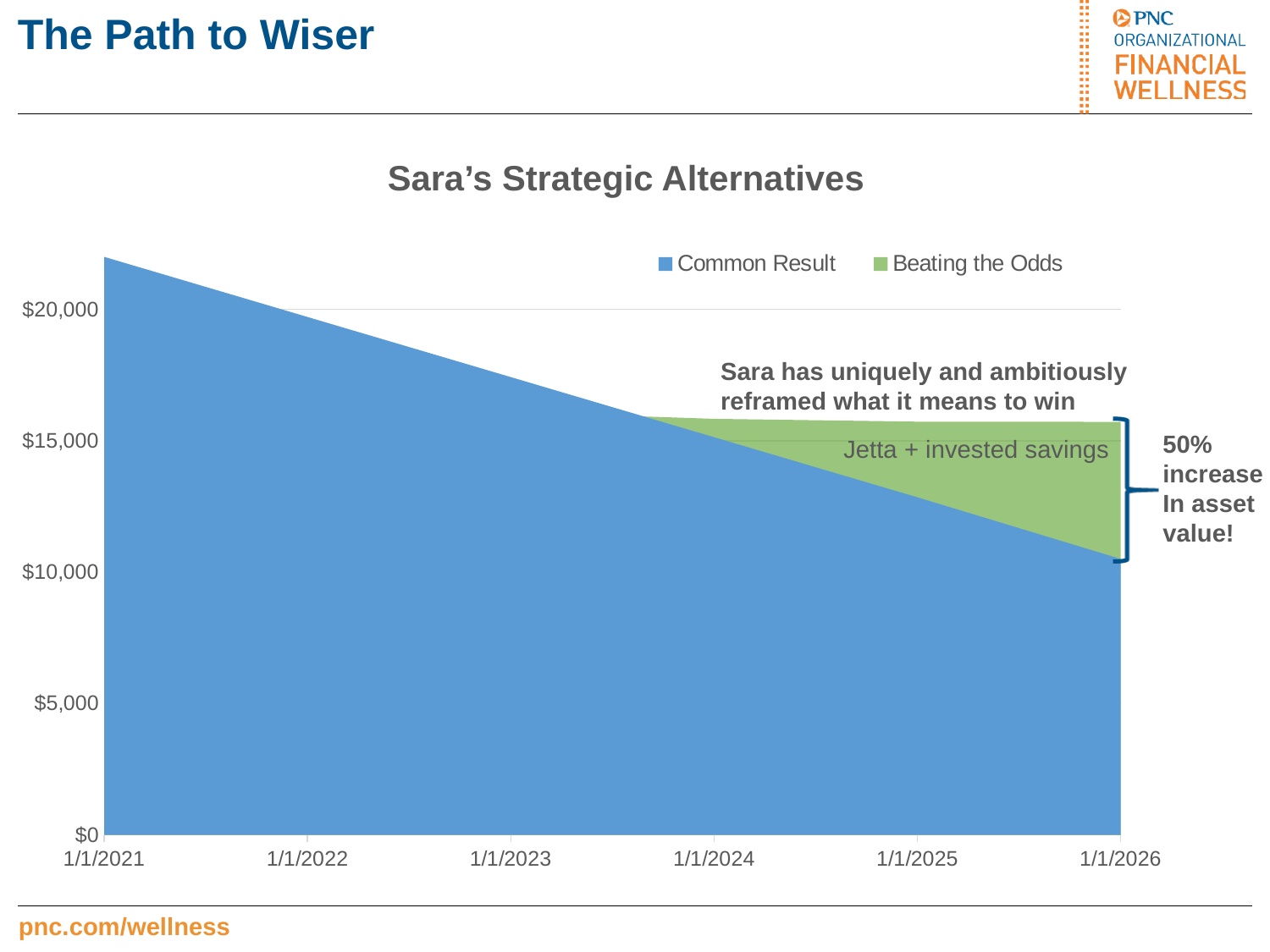
Does the Common Result series rise or fall from 1/1/2021 to 1/1/2026? Fall What kind of chart is shown on the slide? Area chart What is the title of the chart? Sara's Strategic Alternatives How many series does the legend list? 2 At 1/1/2026, which series reaches a higher value, Common Result or Beating the Odds? Beating the Odds Is the top of the Beating the Odds area at 1/1/2026 greater or less than $10,000? greater Is the value for Common Result at 1/1/2026 greater or less than $15,000? less Is the value for Common Result at 1/1/2024 greater or less than $20,000? less How many date labels are shown on the x axis? 6 Which series is shown in green in the legend? Beating the Odds